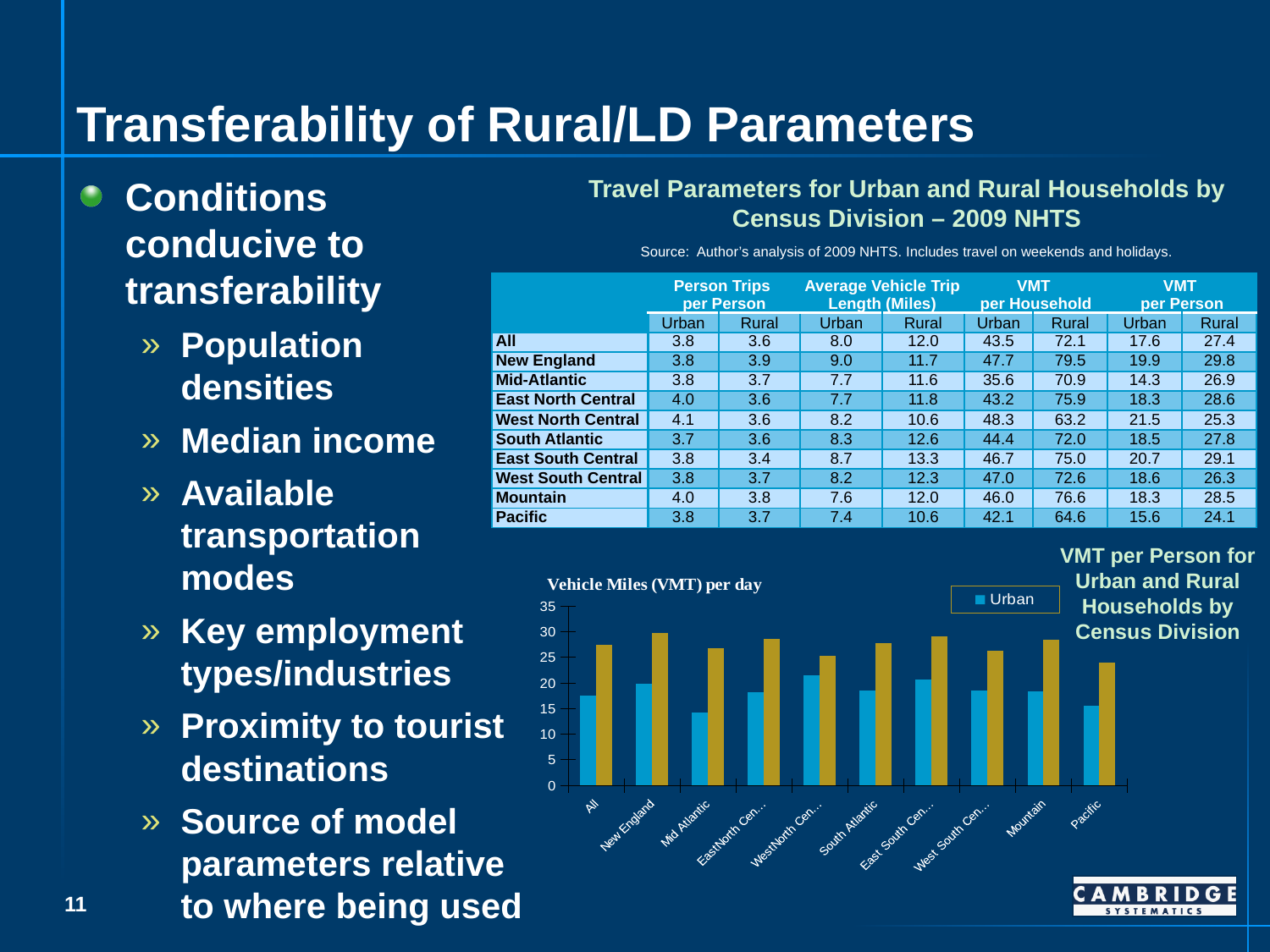
What kind of chart is shown at the bottom of the slide? bar chart In the bar chart, which has the larger Urban value: New England or Mid Atlantic? New England What is the title printed above the bar chart? Vehicle Miles (VMT) per day In the bar chart, is the Rural (gold) value for All greater or less than 25? greater In the bar chart, is the Rural (gold) value for New England greater or less than 25? greater In the bar chart, is the Urban value for All greater or less than 15? greater Which series name is shown in the visible legend entry of the bar chart? Urban In the bar chart, which is larger for All: the Urban bar or the Rural bar? Rural In the bar chart, which category has the lowest Urban value? Mid Atlantic How many census division categories are plotted along the x axis of the bar chart? 10